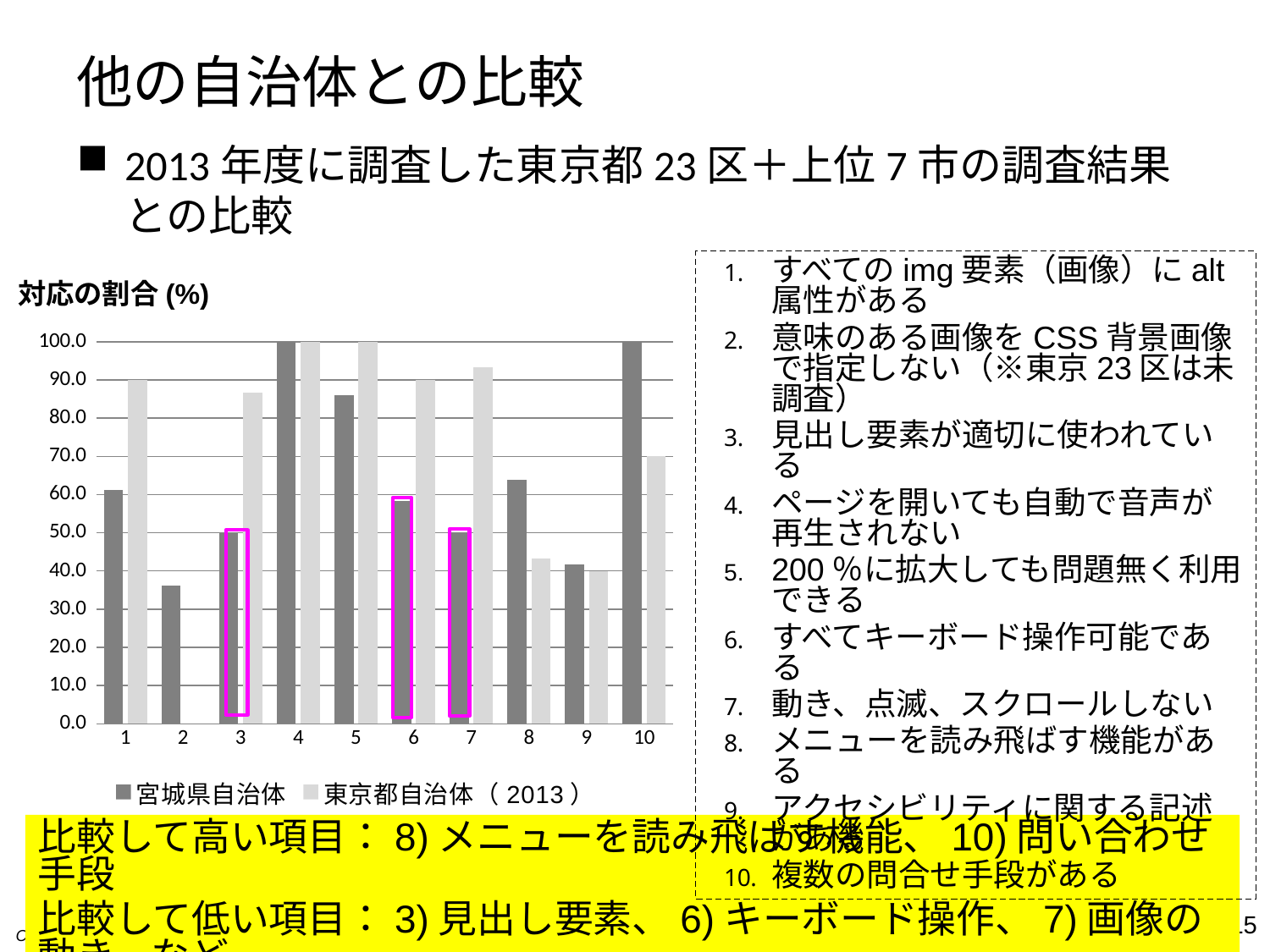
What is the value for 東京都自治体（2013） at category 5? 100.0 How many series does the chart legend list? 2 Is the value for 宮城県自治体 at category 2 greater or less than 40? less Is the value for 東京都自治体（2013） at category 8 greater or less than 50? less What is the value for 宮城県自治体 at category 4? 100.0 How many categories are shown on the x axis of the chart? 10 At category 8, which series has the larger value, 宮城県自治体 or 東京都自治体（2013）? 宮城県自治体 What is the value for 宮城県自治体 at category 10? 100.0 What is the title of the chart? 対応の割合 (%) Is the value for 宮城県自治体 at category 1 greater or less than 50? greater At category 1, which series has the larger value, 宮城県自治体 or 東京都自治体（2013）? 東京都自治体（2013） What kind of chart is shown on the slide? bar chart